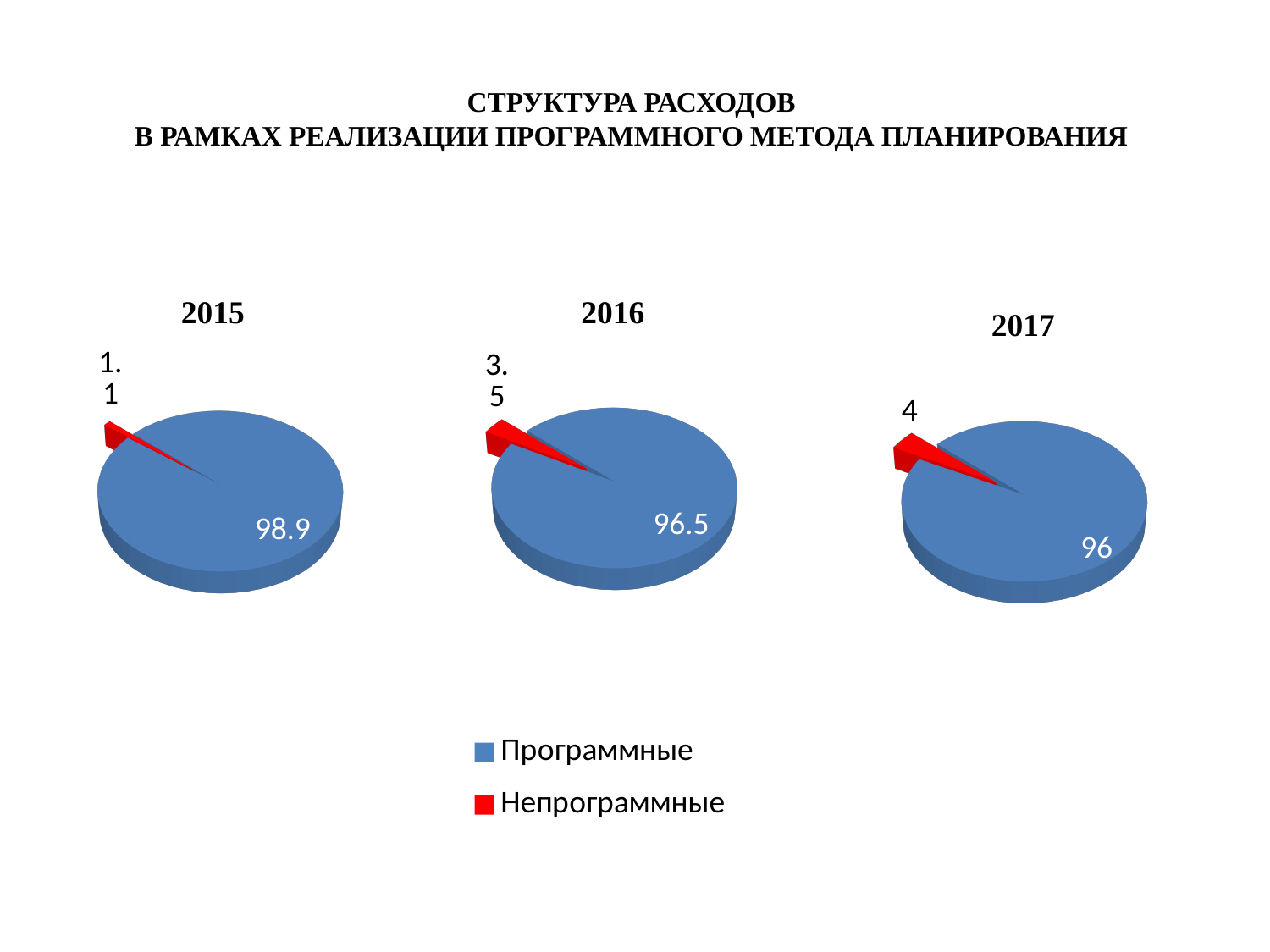
In the 2016 pie chart, what is the value for Программные? 96.5 In the 2015 pie chart, what is the value for Программные? 98.9 In the 2016 pie chart, what is the value for Непрограммные? 3.5 In the 2015 pie chart, which category has the smallest slice? Непрограммные In the 2017 pie chart, what is the value for Программные? 96 In the 2017 pie chart, what is the value for Непрограммные? 4 In the 2017 pie chart, which category has the largest slice? Программные How many series does the legend list? 2 What kind of chart is used for 2016? Pie chart What is the difference between the Программные value in the 2015 chart and the Программные value in the 2017 chart? 2.9 In the 2015 pie chart, what is the value for Непрограммные? 1.1 Which is larger: the Непрограммные value in the 2016 chart or in the 2017 chart? 2017